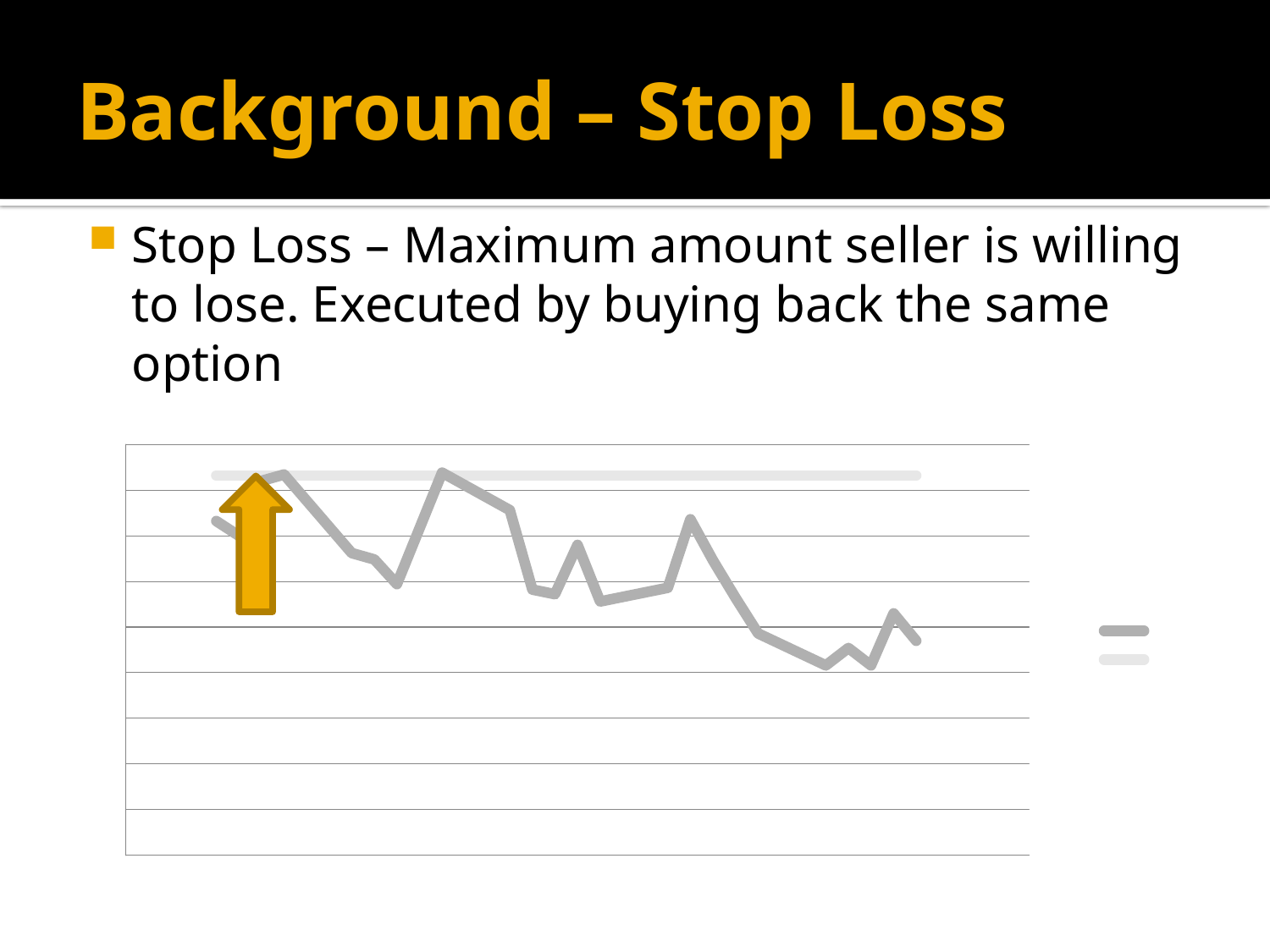
What kind of chart is shown on the slide? line chart What colour is the plotted line in the chart? gray How many entries does the legend to the right of the chart show? 2 Do the values of the jagged line generally rise or fall from left to right? fall What colour is the arrow drawn over the chart? orange